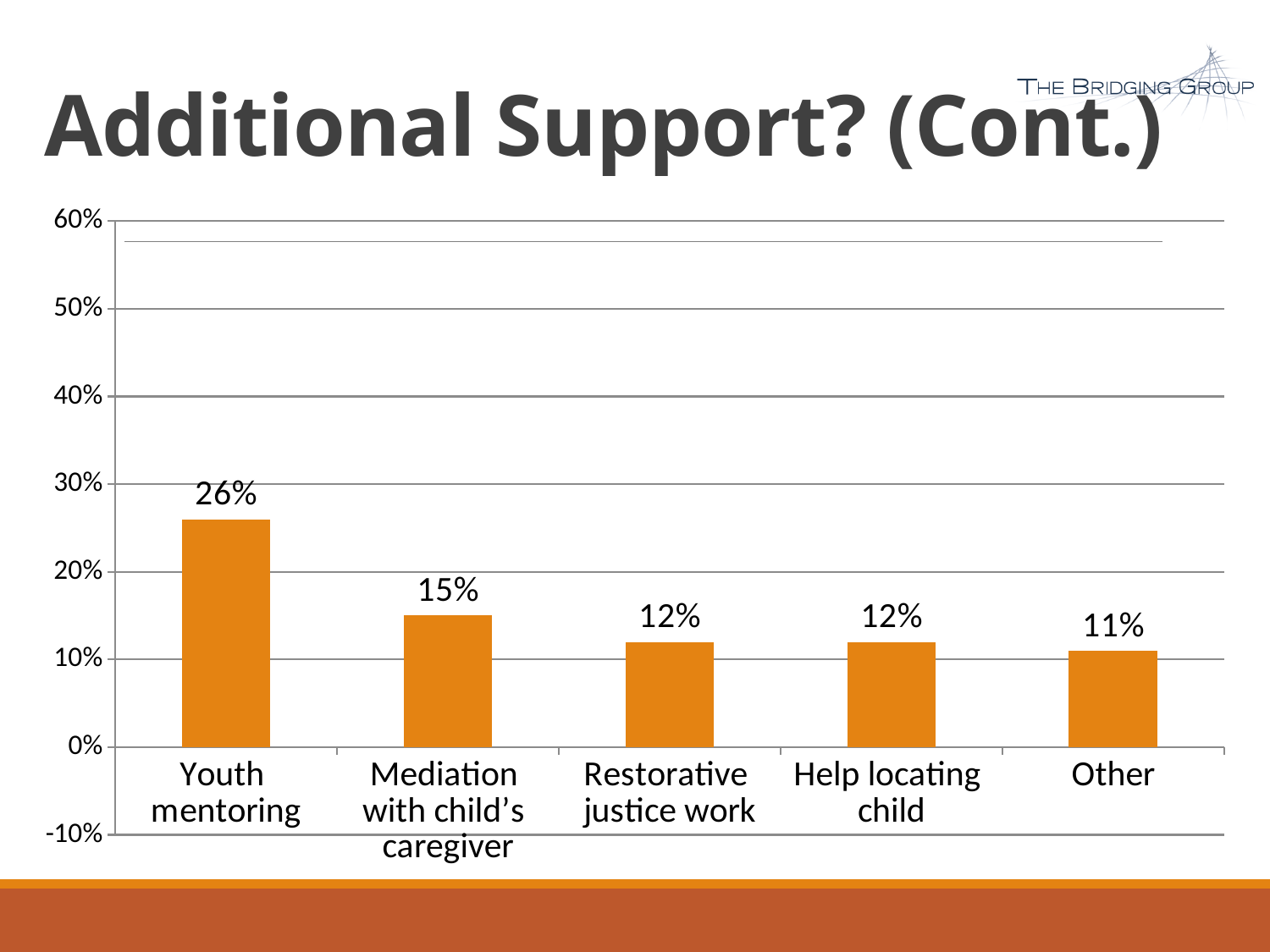
What is the value for Mediation with child's caregiver? 15% What is the value for Restorative justice work? 12% What kind of chart is shown on the slide? bar chart Which is larger, the value for Mediation with child's caregiver or the value for Help locating child? Mediation with child's caregiver Is the value for Youth mentoring greater or less than 20%? greater Which category has the lowest value? Other Which category has the highest value? Youth mentoring What is the title of the slide? Additional Support? (Cont.) What is the value for Youth mentoring? 26% What is the difference between the values for Youth mentoring and Mediation with child's caregiver? 11% What is the value for Other? 11% How many categories are shown on the chart? 5